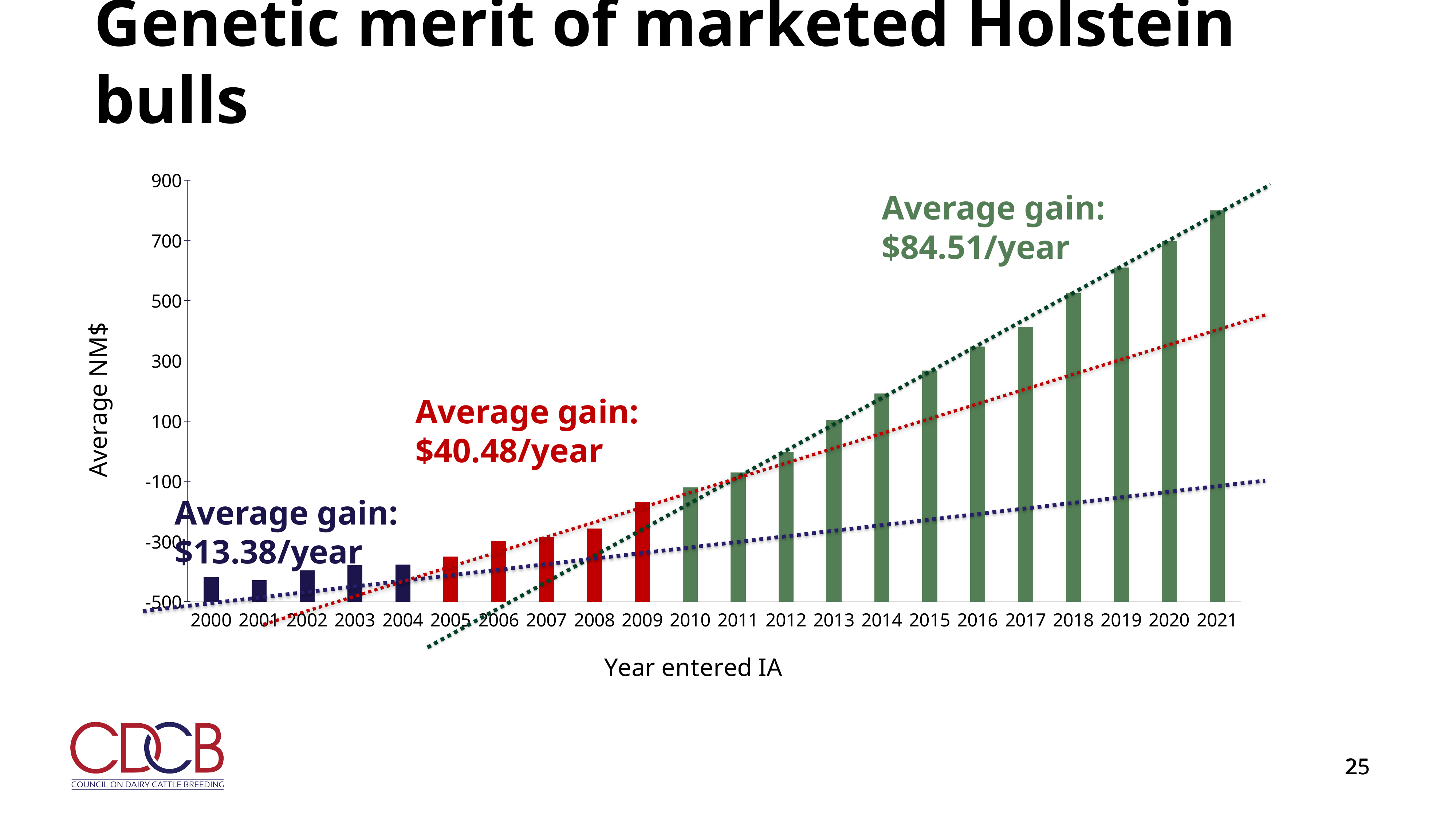
Is the value for 2019 greater or less than 500? greater Is the value for 2009 greater or less than -100? less Is the value for 2021 greater or less than 700? greater Which year has the larger Average NM$, 2010 or 2021? 2021 How many years (bars) are plotted on the x axis? 22 What kind of chart is shown on the slide? bar chart Do the Average NM$ values rise or fall from 2000 to 2021? rise What average gain per year is annotated for the green bars (2010 onward)? $84.51/year Which year has the highest Average NM$? 2021 What is the title of the y axis? Average NM$